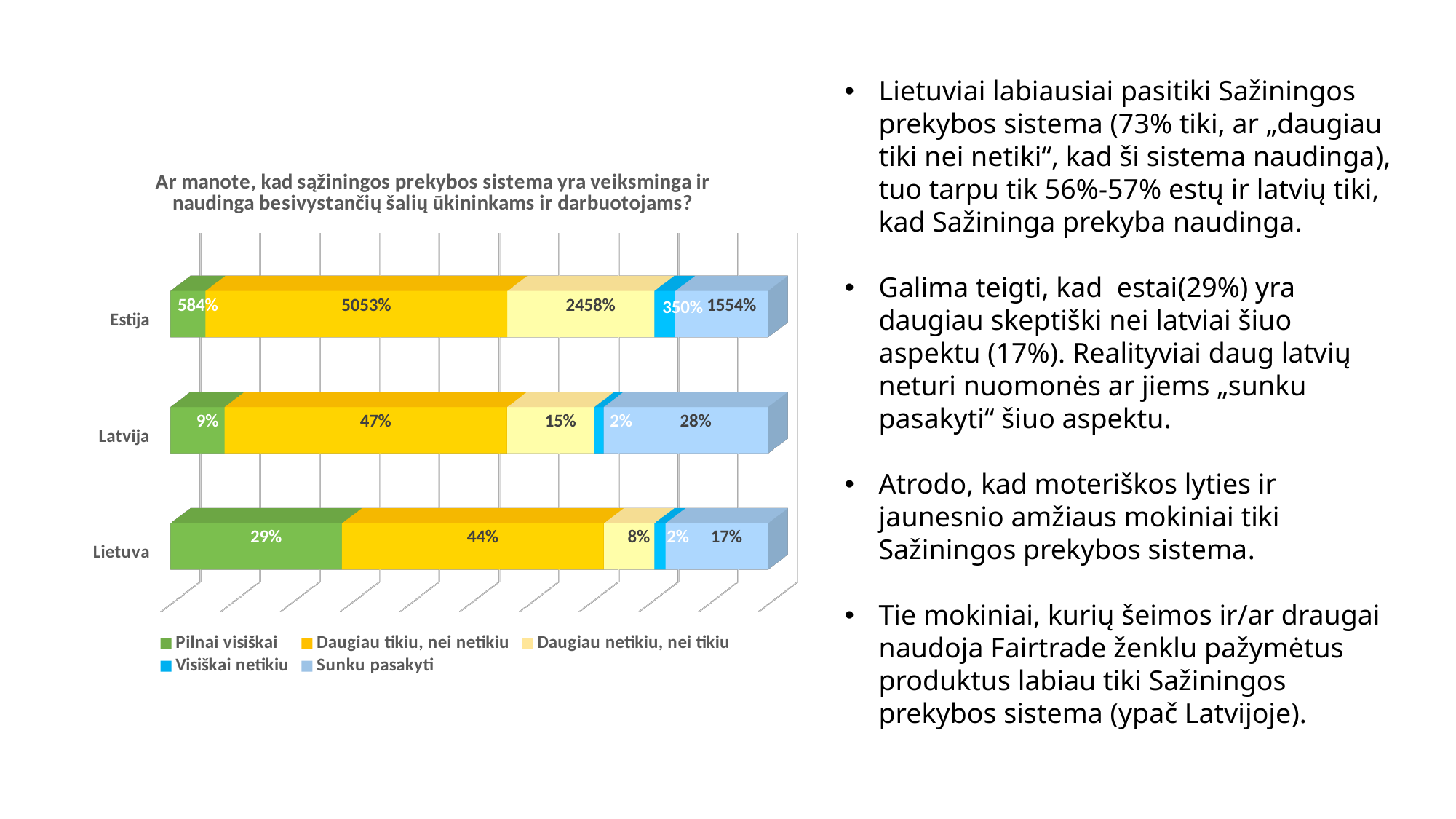
Which country has the largest "Pilnai visiškai" segment? Lietuva What is the difference between the "Sunku pasakyti" values for Latvija (28%) and Lietuva (17%)? 11 percentage points How many series does the legend list? 5 What is the value for Lietuva in the "Daugiau netikiu, nei tikiu" series? 8% How many countries are shown on the chart? 3 What kind of chart is shown on the slide? Stacked bar chart What is the value for Latvija in the "Daugiau tikiu, nei netikiu" series? 47% Which is larger, the "Sunku pasakyti" value for Latvija or for Lietuva? Latvija What is the value for Lietuva in the "Pilnai visiškai" series? 29% What is the value for Latvija in the "Sunku pasakyti" series? 28% What is the total of the Lietuva bar (29% + 44% + 8% + 2% + 17%)? 100% For Lietuva, which is larger: the "Pilnai visiškai" segment or the "Daugiau tikiu, nei netikiu" segment? Daugiau tikiu, nei netikiu